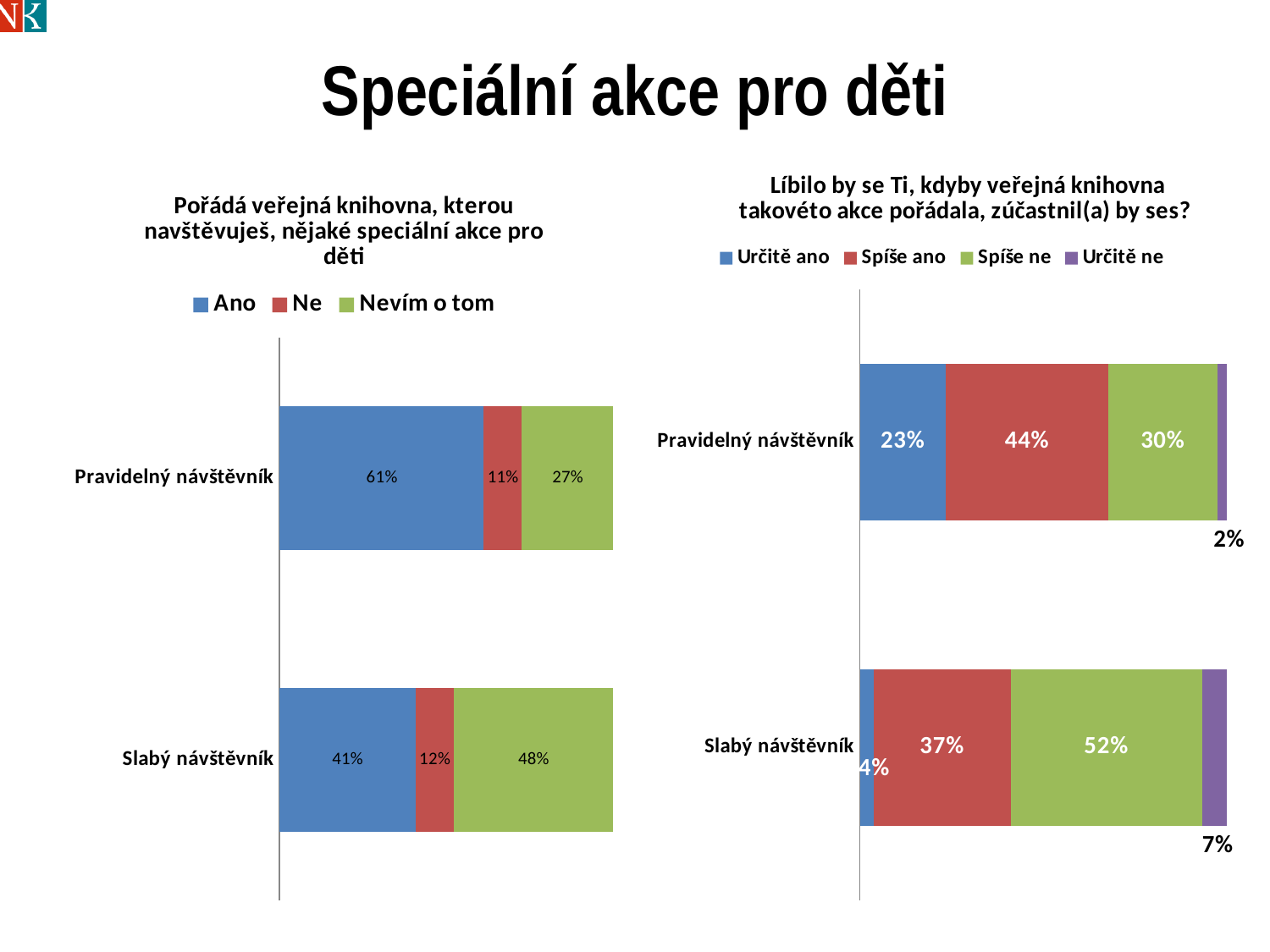
In the right chart ("Líbilo by se Ti..."), which series is the largest segment for Slabý návštěvník? Spíše ne In the left chart ("Pořádá veřejná knihovna..."), what is the difference between the "Ano" values for Pravidelný návštěvník and Slabý návštěvník? 20% In the left chart ("Pořádá veřejná knihovna..."), what is the "Ne" value for Slabý návštěvník? 12% In the right chart ("Líbilo by se Ti..."), what is the "Spíše ano" value for Pravidelný návštěvník? 44% What kind of chart is the right chart ("Líbilo by se Ti...")? Stacked bar chart How many series does the legend of the left chart ("Pořádá veřejná knihovna...") list? 3 In the right chart ("Líbilo by se Ti..."), what is the difference between the "Určitě ano" values for Pravidelný návštěvník and Slabý návštěvník? 19% In the right chart ("Líbilo by se Ti..."), which category has the higher "Spíše ne" value? Slabý návštěvník In the left chart ("Pořádá veřejná knihovna..."), what is the "Nevím o tom" value for Slabý návštěvník? 48% In the right chart ("Líbilo by se Ti..."), what is the "Určitě ne" value for Slabý návštěvník? 7% In the left chart ("Pořádá veřejná knihovna..."), what is the "Ano" value for Pravidelný návštěvník? 61% How many series does the legend of the right chart ("Líbilo by se Ti...") list? 4